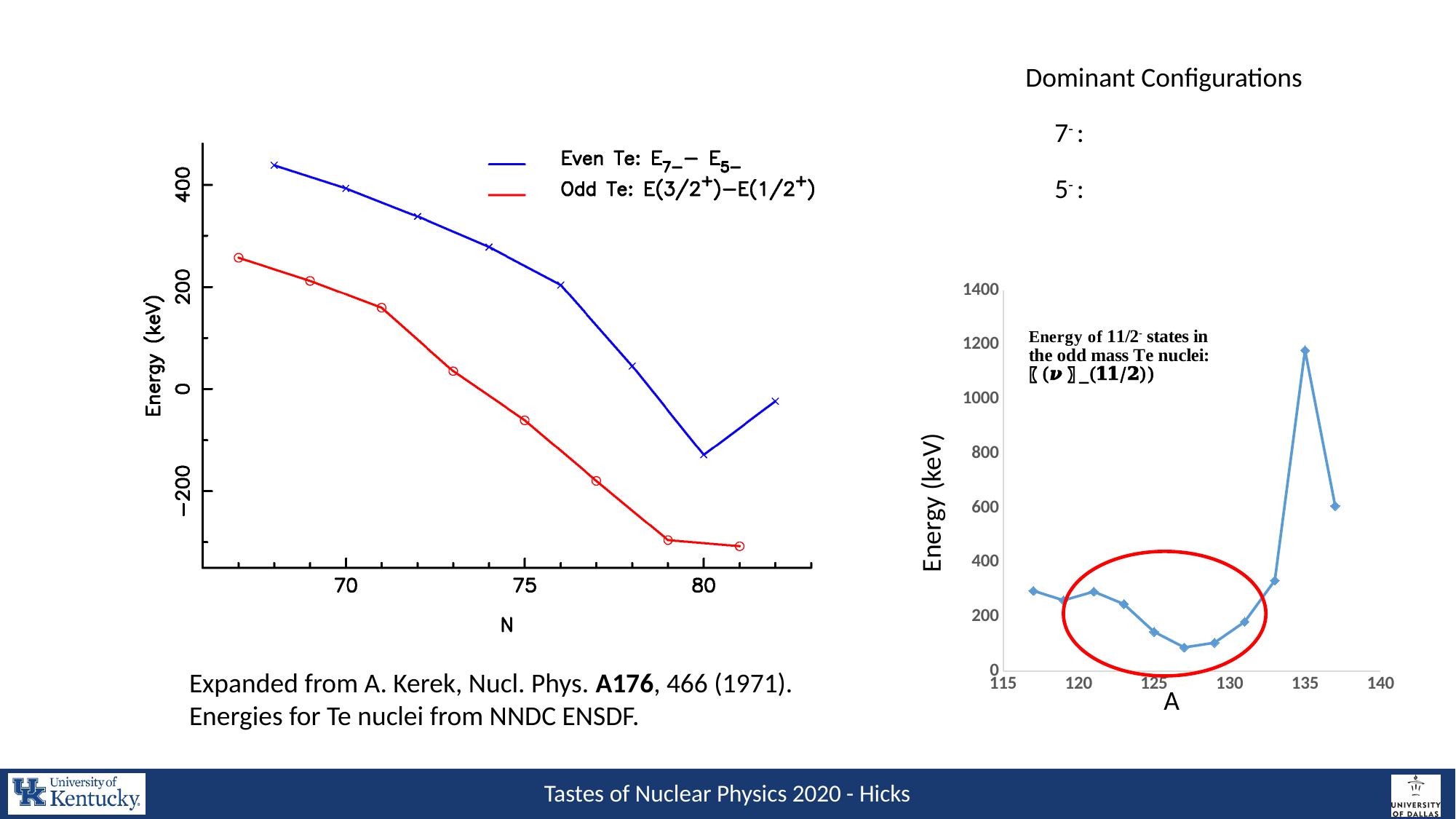
On the right chart (Energy of 11/2- states), at which value of A is the energy highest? 135 On the left chart, is the Odd Te value at N = 79 greater or less than -200? less On the left chart, does the Odd Te line rise or fall as N increases? fall On the left chart, at N = 80, which series has the larger value, Even Te or Odd Te? Even Te On the right chart (Energy of 11/2- states), at which value of A is the energy lowest? 127 On the right chart (Energy of 11/2- states), how many data points are plotted? 11 On the left chart, what kind of chart is it? line chart On the left chart, what colour is the line for Odd Te: E(3/2+)-E(1/2+)? red On the right chart (Energy of 11/2- states), is the value at A = 135 greater or less than 1000? greater On the left chart, is the Even Te value at N = 70 greater or less than 200? greater On the left chart, what is the label of the x axis? N On the left chart, how many series does the legend list? 2